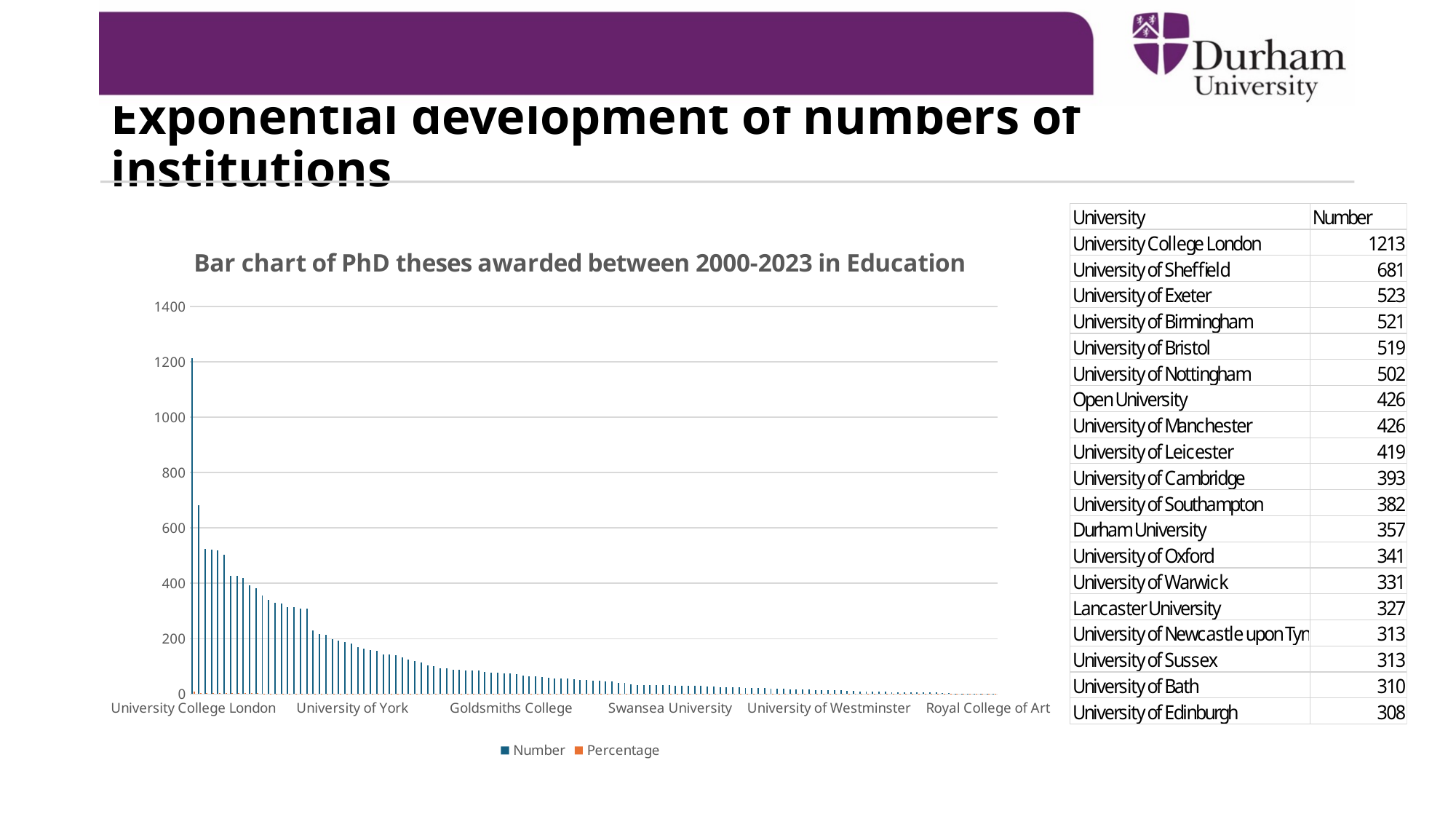
Do the values rise or fall moving from left to right along the x axis? fall Which institution has the highest value in the chart? University College London According to the table on the slide, which is larger, University of Exeter or University of Birmingham? University of Exeter Is the value for Royal College of Art greater or less than 200? less How many series does the chart legend list? 2 According to the table on the slide, what is the difference between University College London and University of Sheffield? 532 According to the table on the slide, what is the number for Durham University? 357 What is the title of the chart? Bar chart of PhD theses awarded between 2000-2023 in Education According to the table on the slide, what is the number for University College London? 1213 What kind of chart is shown on the slide? bar chart Is the value for University College London greater or less than 1000? greater Which series are listed in the chart legend? Number and Percentage